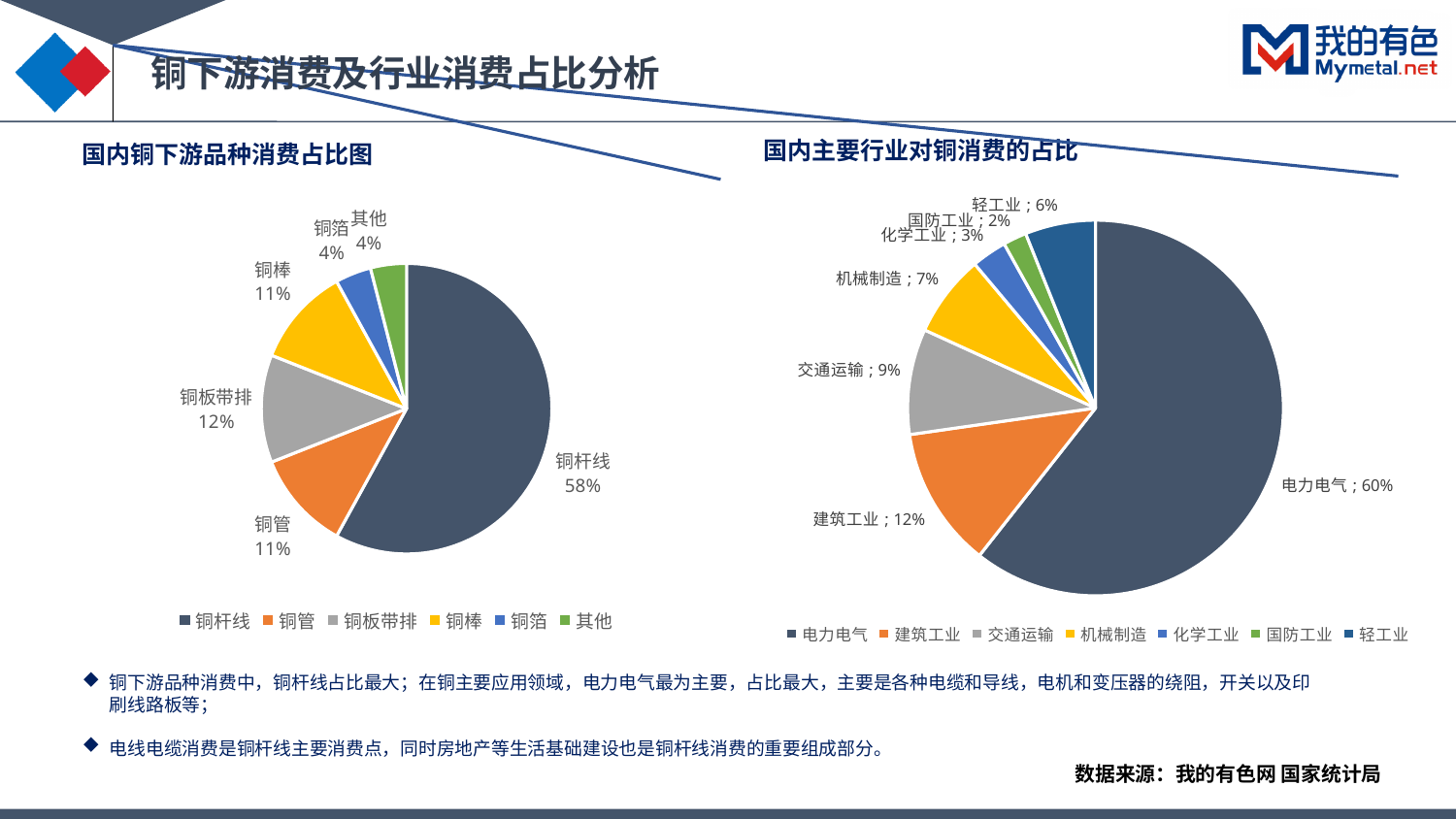
In the chart titled 国内铜下游品种消费占比图, how many categories does the legend list? 6 In the chart titled 国内主要行业对铜消费的占比, what share does 电力电气 have? 60% In the chart titled 国内铜下游品种消费占比图, which category has the largest share? 铜杆线 In the chart titled 国内主要行业对铜消费的占比, what is the difference between the shares of 建筑工业 and 化学工业? 9% In the chart titled 国内主要行业对铜消费的占比, how many categories does the legend list? 7 In the chart titled 国内铜下游品种消费占比图, what is the difference between the shares of 铜杆线 and 铜管? 47% In the chart titled 国内主要行业对铜消费的占比, which category has the smallest share? 国防工业 In the chart titled 国内铜下游品种消费占比图, what share does 铜板带排 have? 12% In the chart titled 国内铜下游品种消费占比图, what share does 铜杆线 have? 58% What kind of chart is the one titled 国内铜下游品种消费占比图? Pie chart In the chart titled 国内主要行业对铜消费的占比, which has a larger share, 交通运输 or 轻工业? 交通运输 In the chart titled 国内主要行业对铜消费的占比, what share does 机械制造 have? 7%